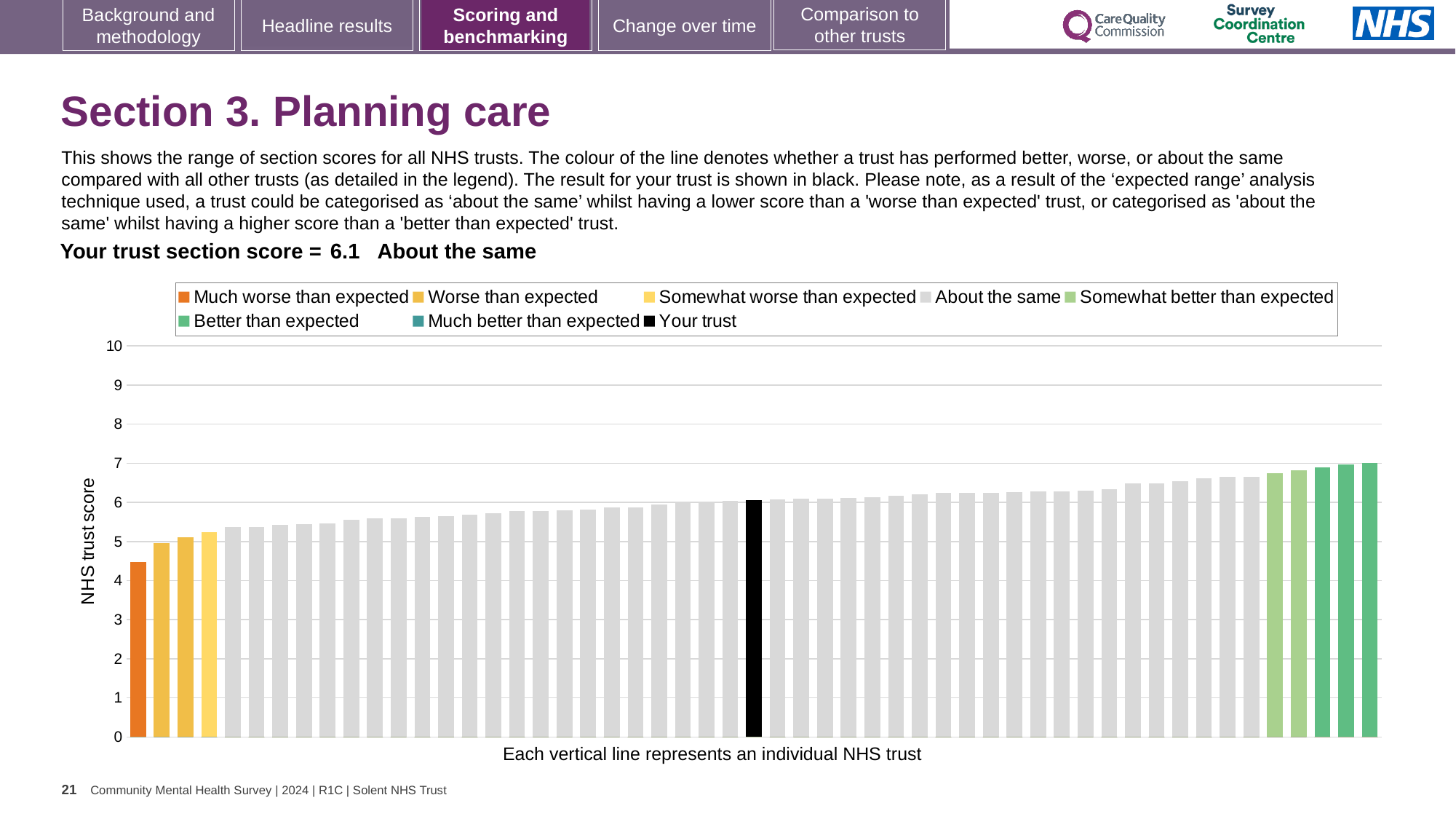
What is the label on the vertical axis of the chart? NHS trust score What colour is the bar representing your trust? black What kind of chart is shown on the slide? bar chart Do the bar values rise or fall from left to right along the x axis? rise How many bars are coloured as 'Much worse than expected'? 1 Is the value of the lowest bar in the chart greater or less than 5? less Is the value of the black 'Your trust' bar greater or less than 5? greater How many entries does the chart legend list? 8 Which legend category does the lowest bar in the chart belong to? Much worse than expected Which performance category is your trust placed in for Section 3. Planning care? About the same Is the value of the highest bar in the chart greater or less than 8? less What is the section score for your trust shown on the slide? 6.1